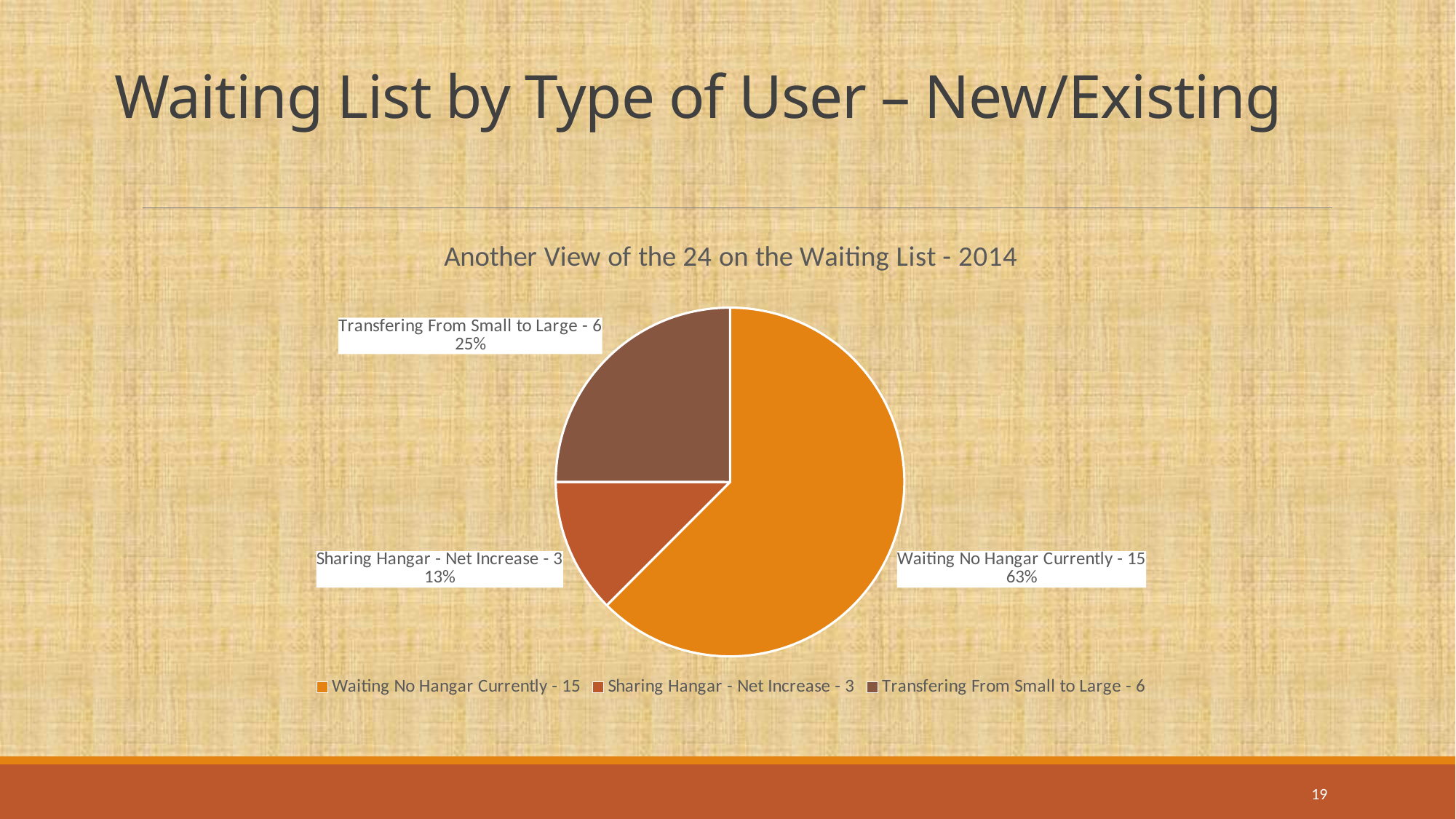
What is the title of the chart? Another View of the 24 on the Waiting List - 2014 How many entries does the legend list? 3 Which slice is larger: 'Transfering From Small to Large - 6' or 'Sharing Hangar - Net Increase - 3'? Transfering From Small to Large - 6 How many slices does the pie chart have? 3 Which category has the smallest slice of the pie? Sharing Hangar - Net Increase - 3 What percentage share does the 'Waiting No Hangar Currently - 15' slice have? 63% What colour is the 'Waiting No Hangar Currently - 15' slice? Orange What percentage share does the 'Sharing Hangar - Net Increase - 3' slice have? 13% What type of chart is shown on the slide? Pie chart What percentage share does the 'Transfering From Small to Large - 6' slice have? 25% What is the difference in percentage points between the 'Waiting No Hangar Currently - 15' slice and the 'Transfering From Small to Large - 6' slice? 38% Which category has the largest slice of the pie? Waiting No Hangar Currently - 15